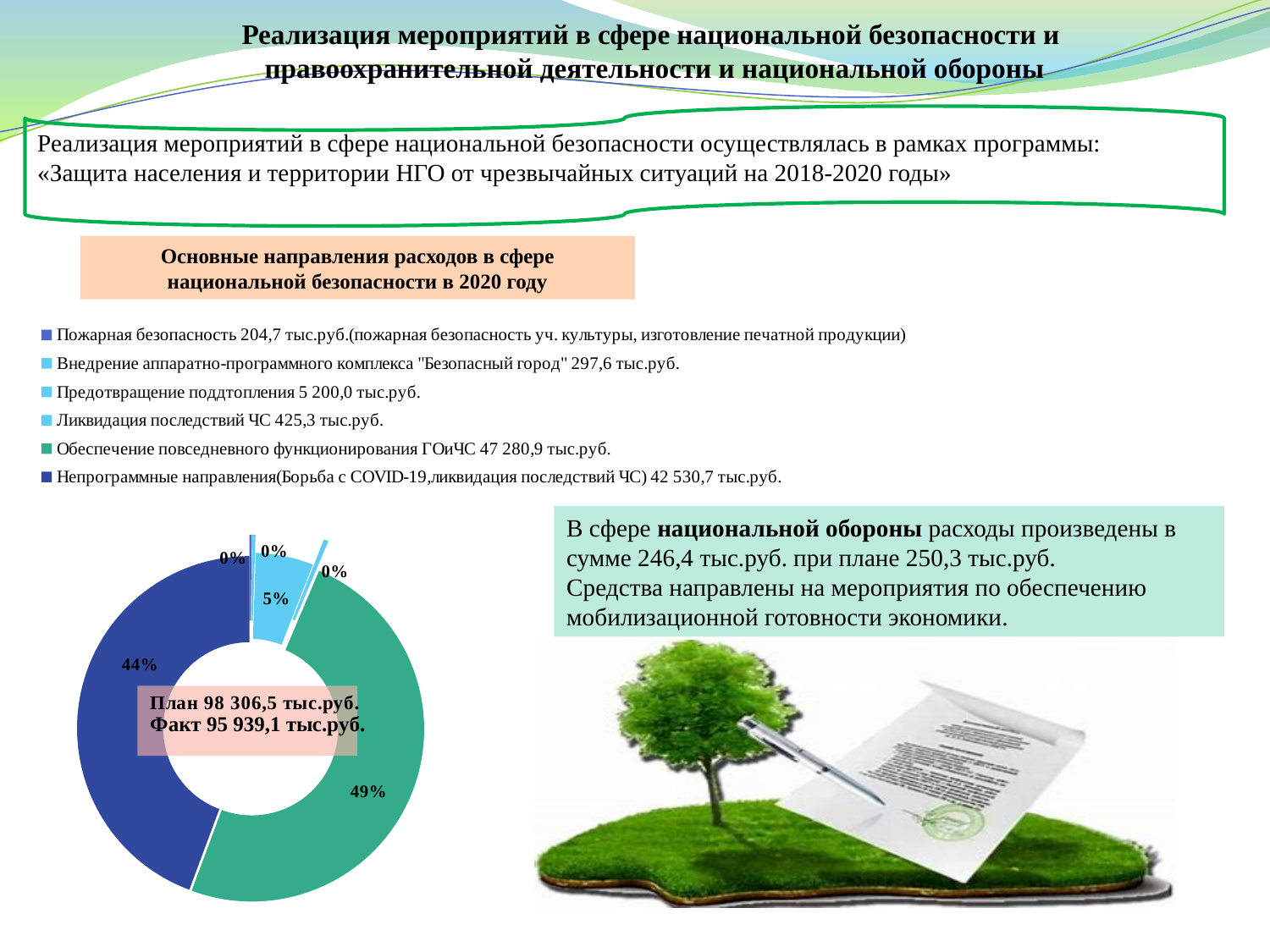
What is the title of the chart? Основные направления расходов в сфере национальной безопасности в 2020 году What kind of chart is shown on the slide? Doughnut (pie) chart Which is larger: the share for Обеспечение повседневного функционирования ГОиЧС or the share for Непрограммные направления? Обеспечение повседневного функционирования ГОиЧС What is the difference in percentage points between the 49% slice and the 44% slice? 5 percentage points Which category has the largest share of the doughnut chart? Обеспечение повседневного функционирования ГОиЧС What share of the chart does Предотвращение подтопления account for? 5% What share of the chart does Непрограммные направления account for? 44% How many slices does the doughnut chart have? 6 According to the legend, what amount is given for Пожарная безопасность? 204,7 тыс.руб. How many entries does the chart legend list? 6 What share of the chart does Обеспечение повседневного функционирования ГОиЧС account for? 49% What plan value is printed in the centre of the doughnut chart? 98 306,5 тыс.руб.